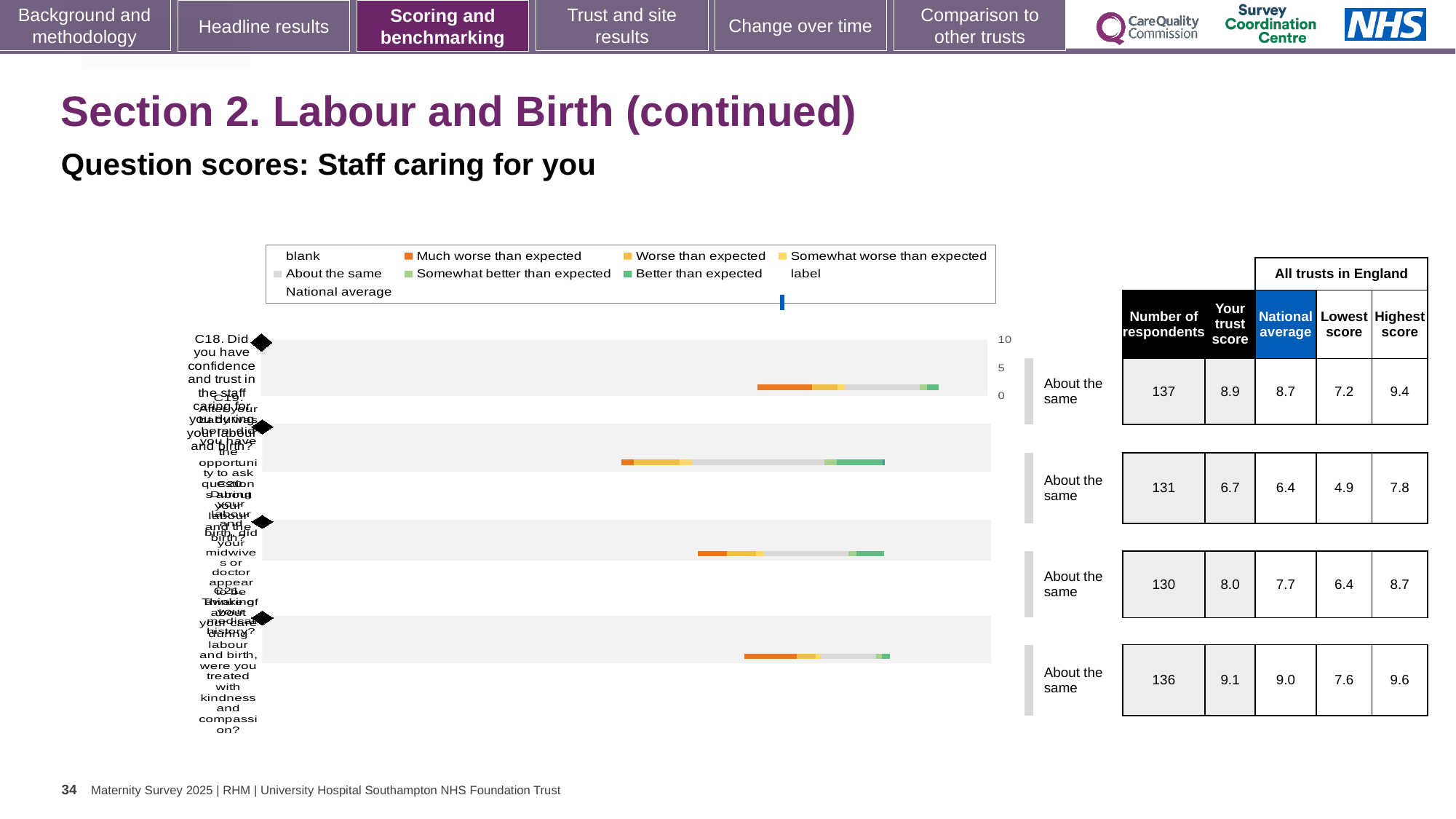
What is the difference between the highest score and the lowest score for the fourth row (C21)? 2.0 What is the lowest score among all trusts in England for the third row (C20)? 6.4 How many questions (rows) are plotted in the chart? 4 What is the highest score among all trusts in England for the second row (C19)? 7.8 Which question has the lowest 'Your trust score'? C19 What kind of chart is used to show the question scores on this slide? bar chart What is the 'Your trust score' value for the first row (C18)? 8.9 What benchmark category is shown for all four questions? About the same For the third row (C20), which is larger: the trust score or the national average? the trust score What is the number of respondents for the fourth row (C21)? 136 Which question has the highest 'Your trust score'? C21 What is the difference between the trust score and the national average for the first row (C18)? 0.2